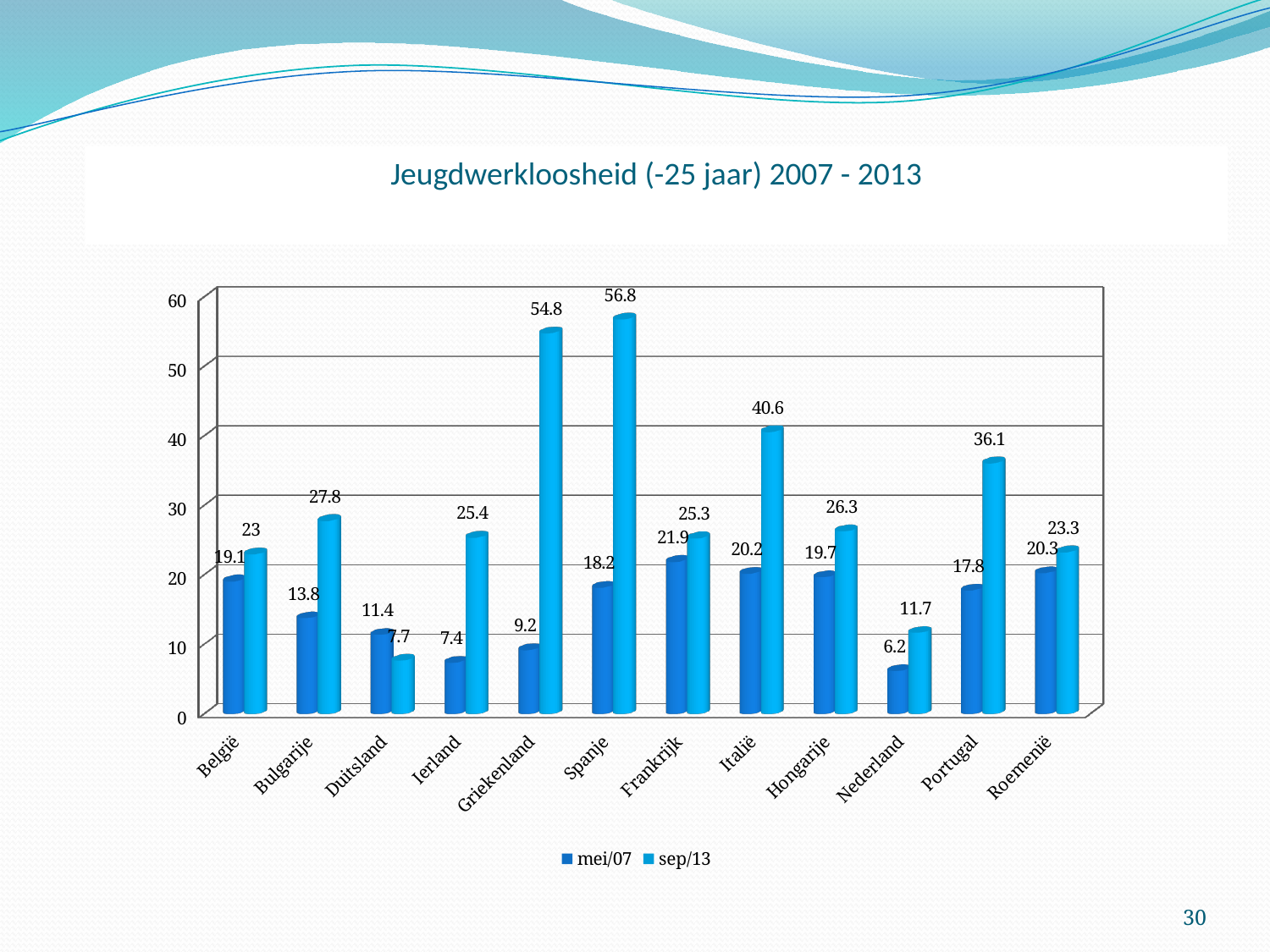
How many countries are shown on the x axis? 12 What is the difference between the sep/13 and mei/07 values for Italië? 20.4 Which country has the lowest mei/07 value? Nederland How many series does the legend list? 2 What is the sep/13 value for Portugal? 36.1 What is the mei/07 value for Frankrijk? 21.9 Which country has the lowest sep/13 value? Duitsland What is the difference between the sep/13 and mei/07 values for Griekenland? 45.6 Which is larger for Duitsland: the mei/07 value or the sep/13 value? mei/07 What is the sep/13 value for Griekenland? 54.8 What kind of chart is shown on the slide? Bar chart Which country has the highest sep/13 value? Spanje